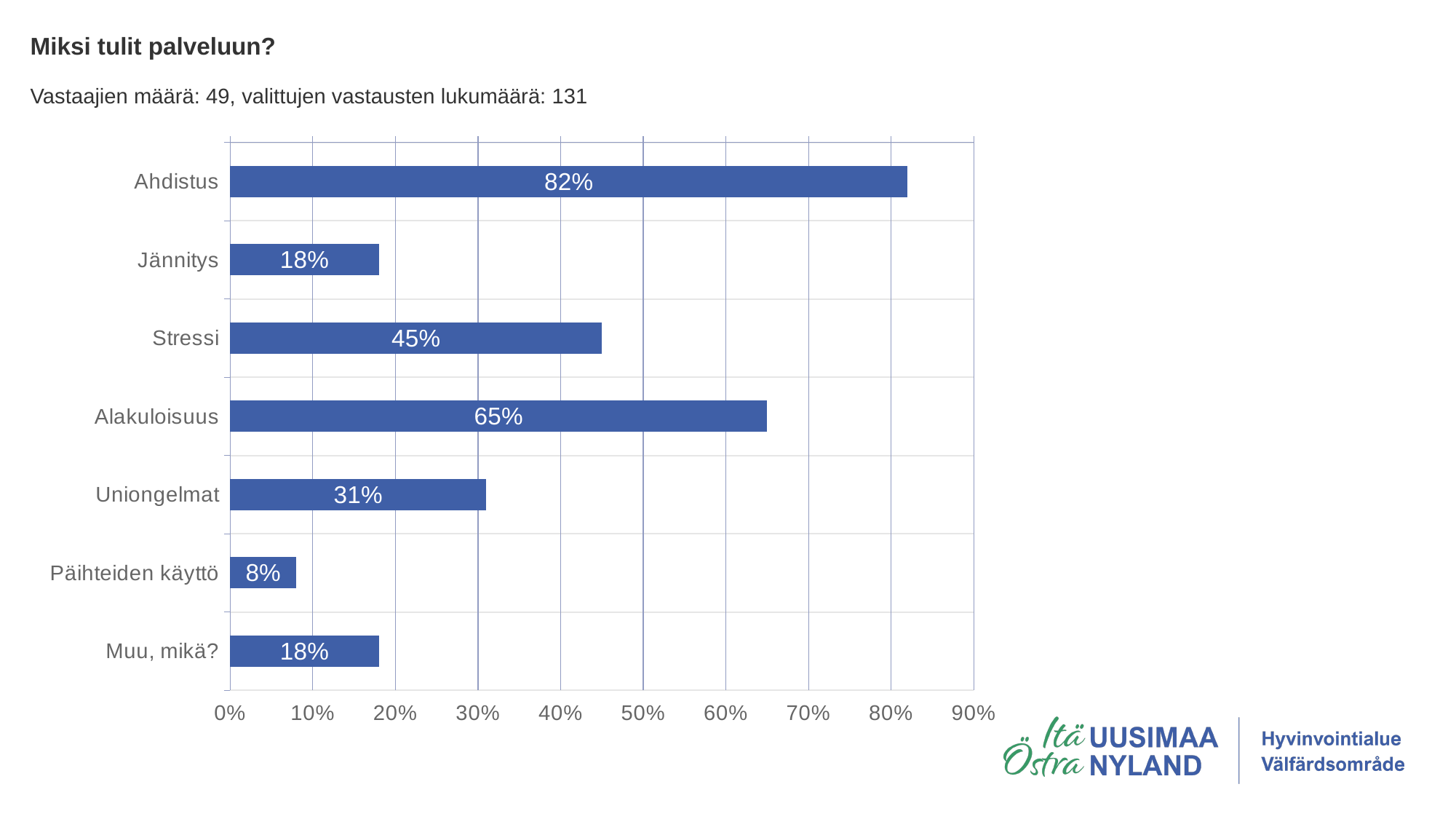
What is the value for Stressi? 45% What is the value for Ahdistus? 82% How many categories are shown in the chart? 7 What is the difference between the values for Ahdistus and Alakuloisuus? 17% What is the value for Uniongelmat? 31% What is the title of the slide? Miksi tulit palveluun? What kind of chart is shown on the slide? bar chart Which category has the lowest value? Päihteiden käyttö Which is larger, the value for Stressi or the value for Uniongelmat? Stressi Which category has the highest value? Ahdistus What is the value for Päihteiden käyttö? 8% Is the value for Alakuloisuus greater or less than 60%? greater